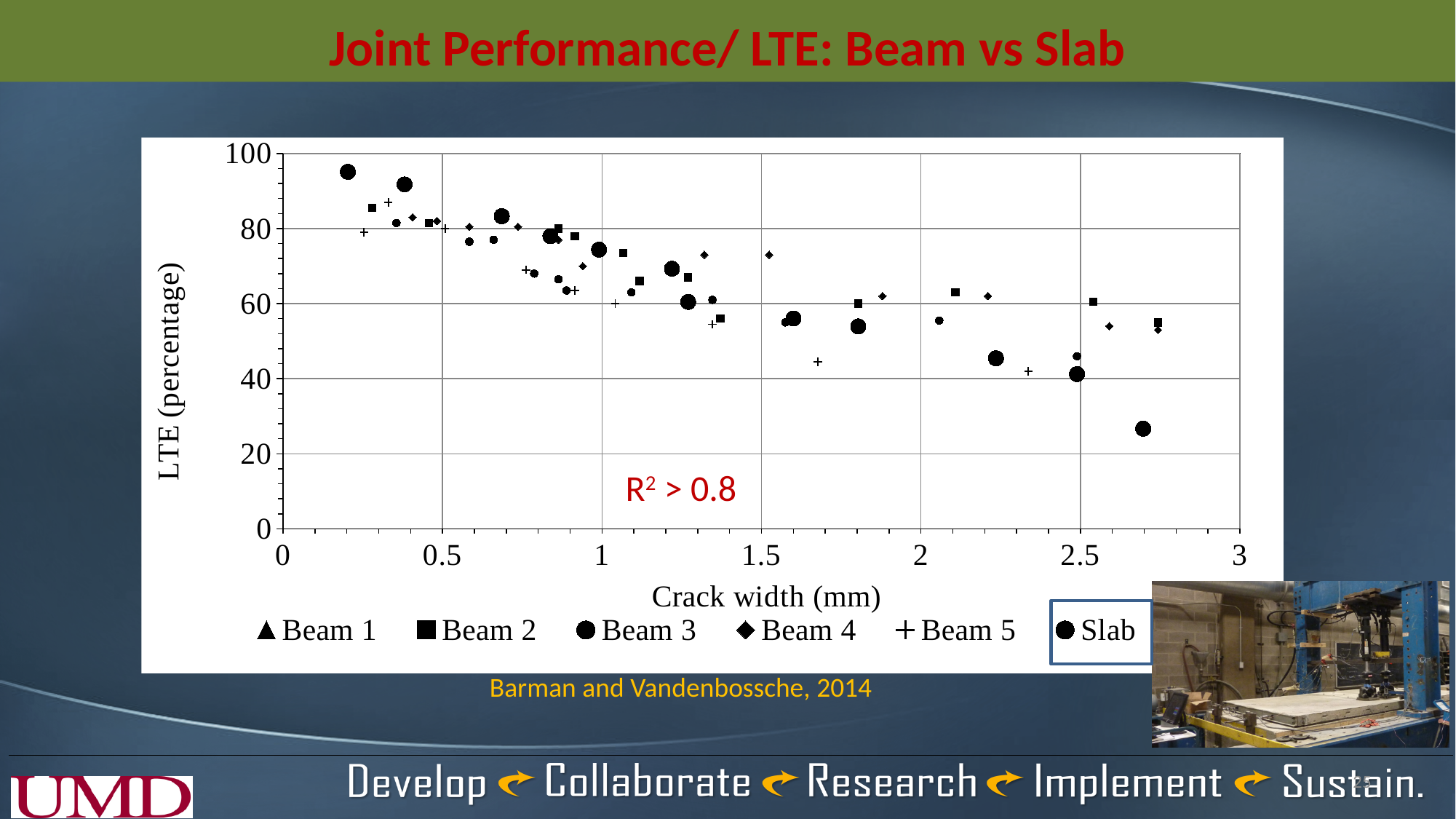
What is the maximum crack width shown on the x axis? 3 Is the LTE value of the lowest Slab point (at a crack width of about 2.7 mm) greater or less than 40? less What is the maximum value shown on the y axis? 100 What is the label of the y axis? LTE (percentage) What kind of chart is shown on the slide? Scatter chart Is the highest LTE value plotted on the chart greater or less than 80? greater How many series does the legend list? 6 As crack width increases along the x axis, do the LTE values generally rise or fall? Fall Is the LTE value of the leftmost Slab point (at a crack width of about 0.2 mm) greater or less than 80? greater